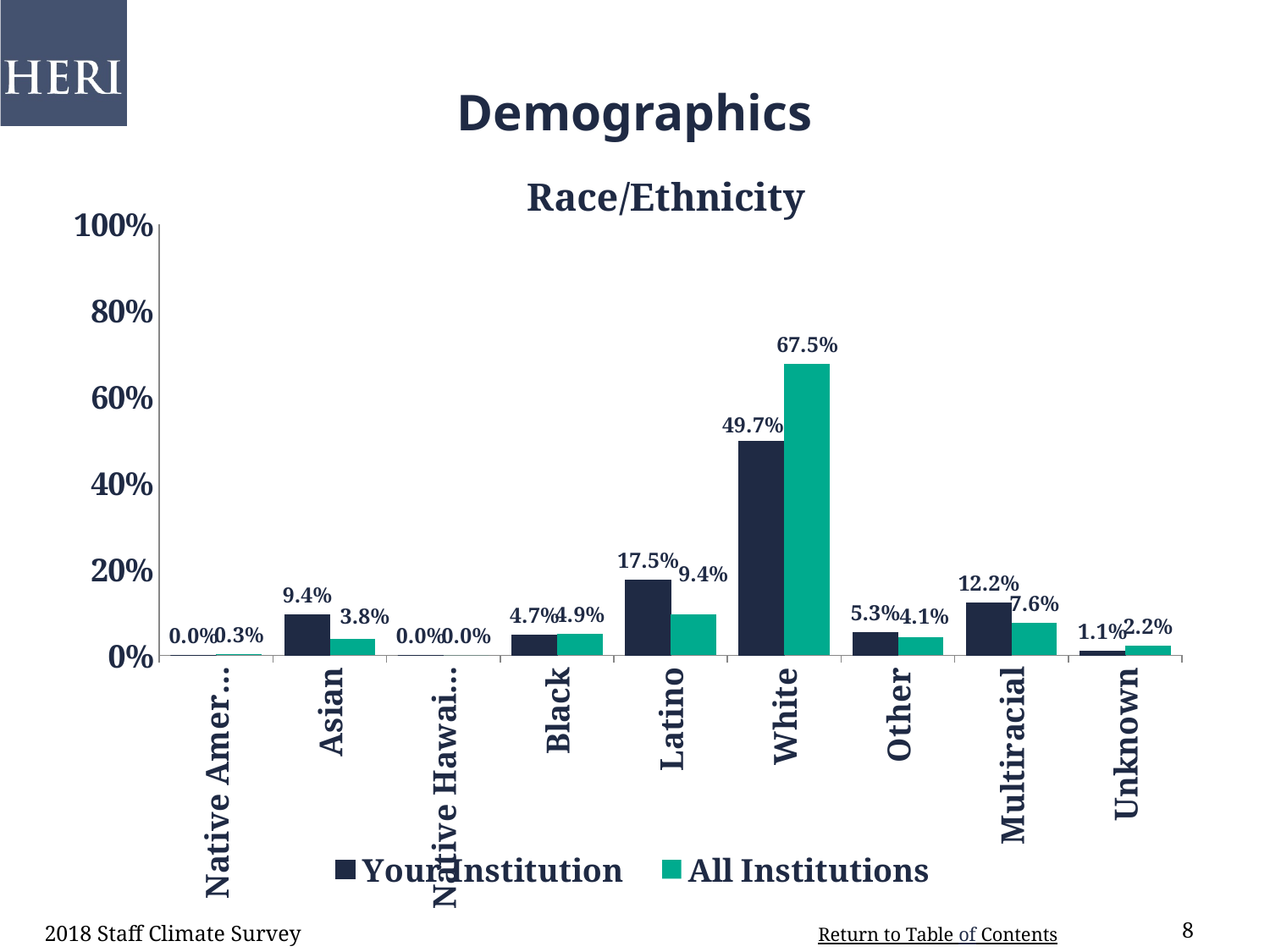
How many race/ethnicity categories are shown on the x axis? 9 How many series does the legend list? 2 What is the value for Latino for All Institutions? 9.4% What is the value for Multiracial for Your Institution? 12.2% Is the value for White for All Institutions greater or less than 60%? greater What is the difference between All Institutions and Your Institution for White? 17.8% What is the difference between Your Institution and All Institutions for Latino? 8.1% What type of chart is shown on the slide? bar chart Which is larger for Asian: Your Institution or All Institutions? Your Institution What is the chart's title? Race/Ethnicity What is the value for White for Your Institution? 49.7% Which category has the highest value for All Institutions? White